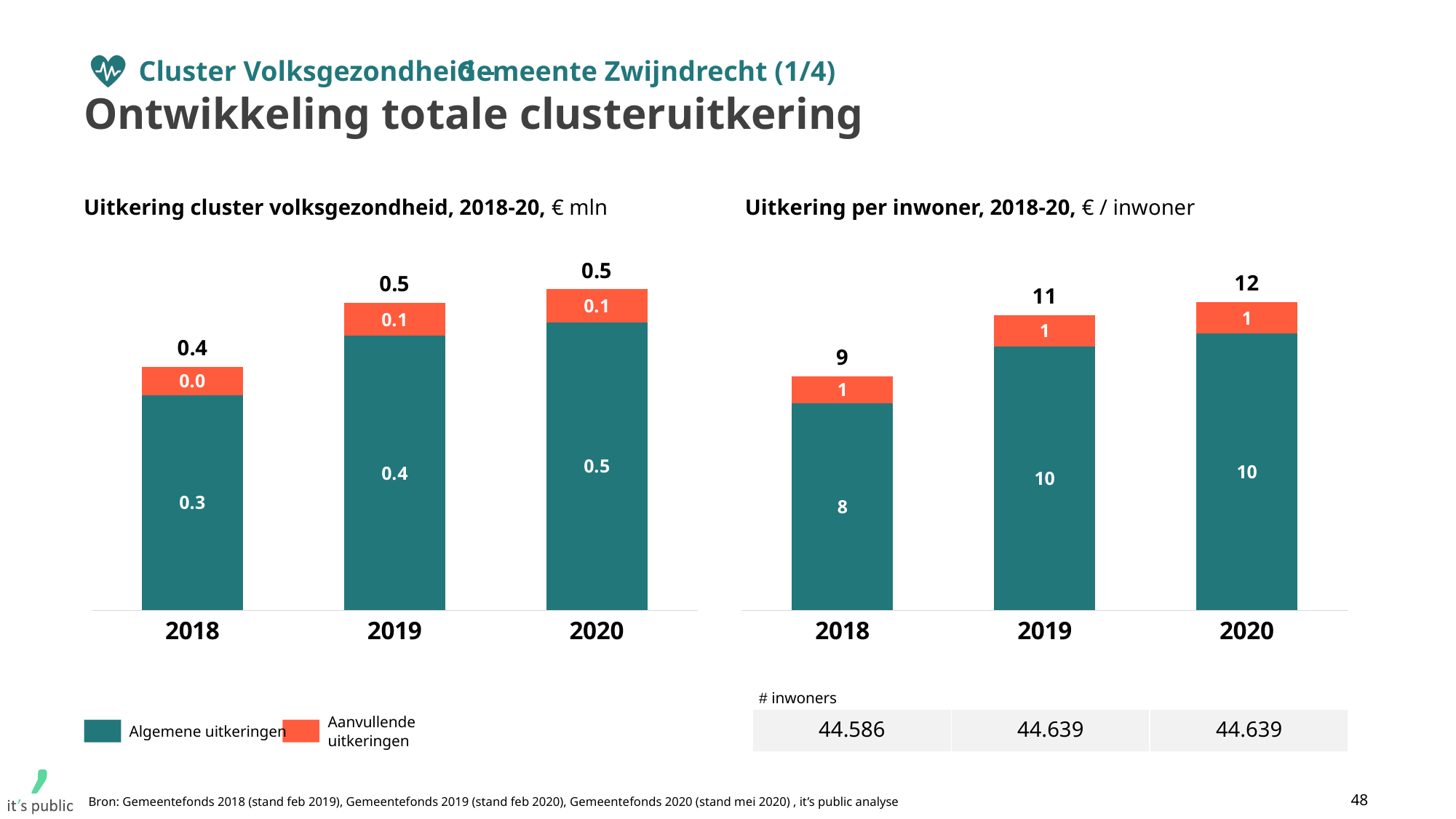
In the chart 'Uitkering cluster volksgezondheid, 2018-20', what is the total of the stacked bar for 2019? 0.5 In the chart 'Uitkering per inwoner, 2018-20', what is the difference between the total for 2020 and the total for 2018? 3 In the chart 'Uitkering per inwoner, 2018-20', what is the value of Algemene uitkeringen for 2019? 10 In the chart 'Uitkering per inwoner, 2018-20', how many years are shown on the x axis? 3 In the chart 'Uitkering per inwoner, 2018-20', which year has the highest total uitkering per inwoner? 2020 In the chart 'Uitkering cluster volksgezondheid, 2018-20', how many series does the legend list? 2 In the chart 'Uitkering per inwoner, 2018-20', do the total values rise or fall from 2018 to 2020? rise In the chart 'Uitkering cluster volksgezondheid, 2018-20', what is the value of Aanvullende uitkeringen for 2020? 0.1 In the chart 'Uitkering cluster volksgezondheid, 2018-20', which year has the lowest total uitkering? 2018 What kind of chart is 'Uitkering cluster volksgezondheid, 2018-20'? stacked bar chart In the chart 'Uitkering per inwoner, 2018-20', which colour represents Aanvullende uitkeringen? orange In the chart 'Uitkering cluster volksgezondheid, 2018-20', what is the value of Algemene uitkeringen for 2018? 0.3